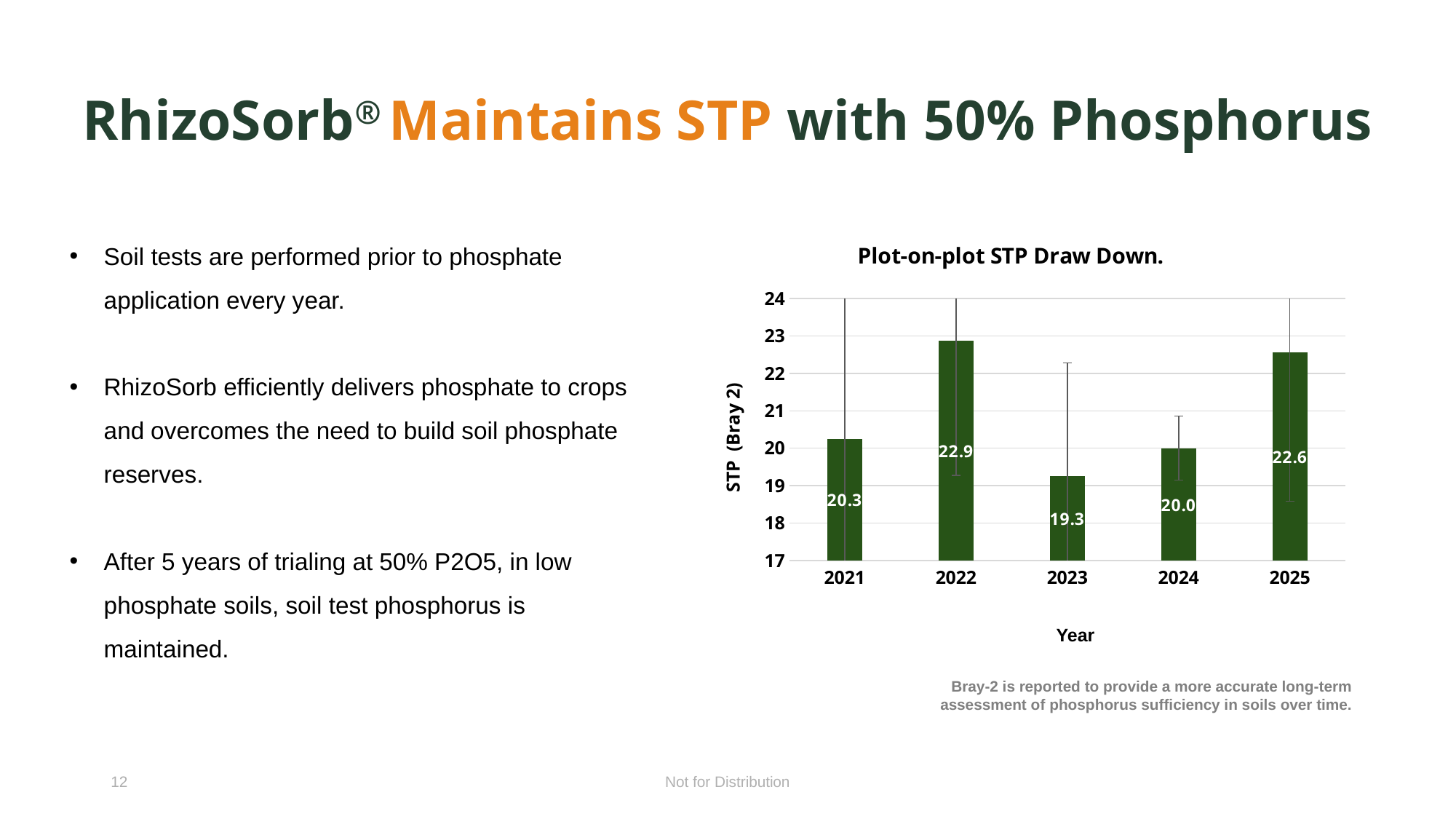
Which year has the larger STP value, 2021 or 2024? 2021 Which year has the highest STP value? 2022 How many years are shown on the x axis? 5 What is the title of the chart? Plot-on-plot STP Draw Down. Which year has the lowest STP value? 2023 Is the value for 2023 greater or less than 20? less What is the STP value for 2025? 22.6 What kind of chart is shown on the slide? bar chart What is the difference between the STP values for 2022 and 2023? 3.6 What is the STP value for 2022? 22.9 What is the STP value for 2021? 20.3 What is the STP value for 2023? 19.3